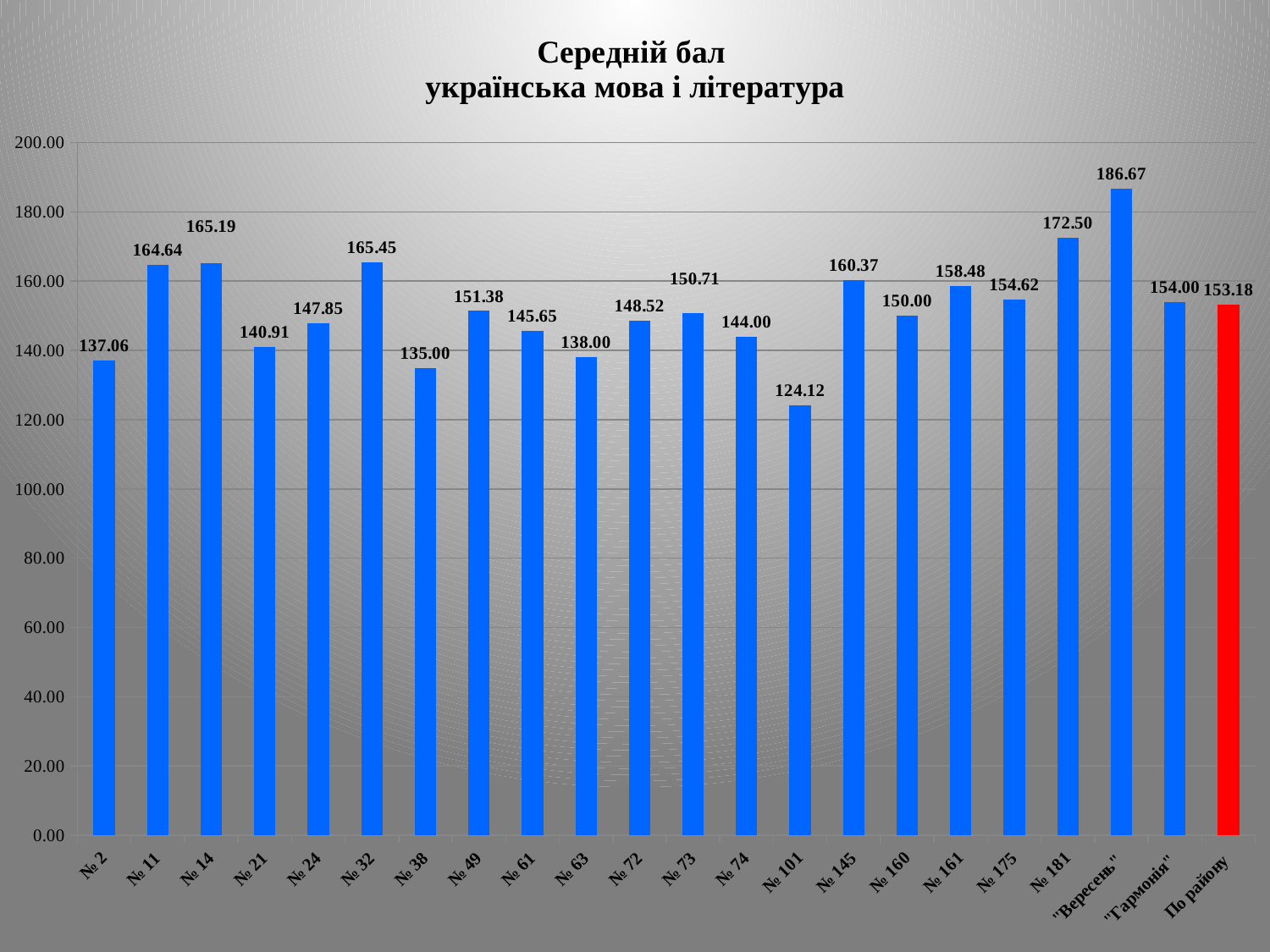
How many categories are shown on the x axis? 22 Is the value for № 38 greater or less than 140? less What is the value for "Вересень"? 186.67 What is the difference between the values for "Вересень" and № 101? 62.55 What is the value for № 2? 137.06 What colour is the bar for По району? Red What is the difference between the values for № 181 and По району? 19.32 Which is larger, the value for № 11 or the value for № 21? № 11 What is the value for По району? 153.18 Which category has the highest value? "Вересень" Which category has the lowest value? № 101 What is the value for № 101? 124.12